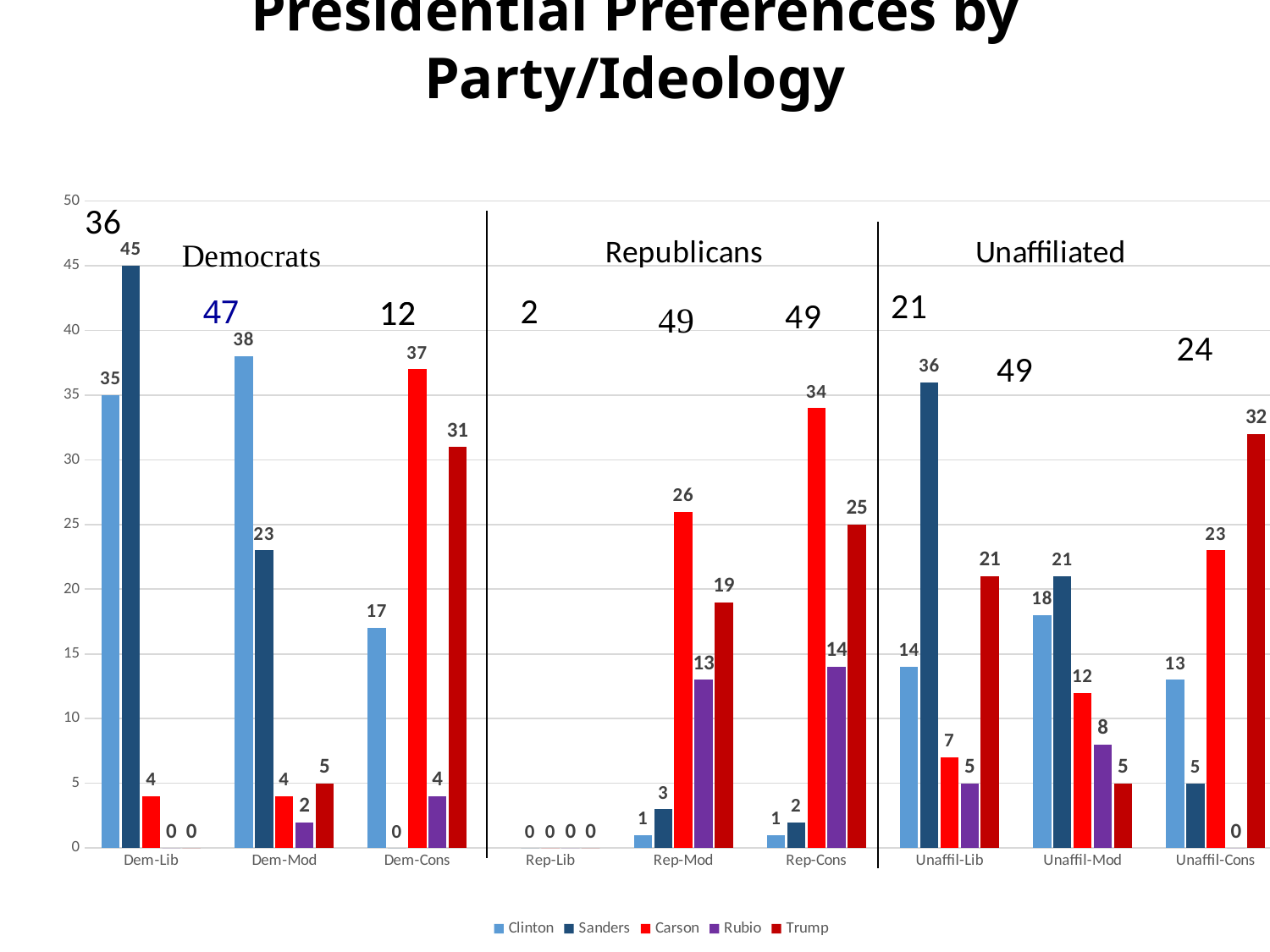
Which candidate has the lowest value in the Dem-Cons category? Sanders What is the value for Sanders in the Dem-Lib category? 45 Which candidate is shown in purple in the legend? Rubio How many categories are shown on the x axis? 9 Which is larger in the Dem-Mod category, Clinton or Sanders? Clinton What is the difference between Carson and Trump in the Rep-Mod category? 7 What kind of chart is shown on the slide? Bar chart How many series does the legend list? 5 What is the value for Trump in the Unaffil-Cons category? 32 What is the value for Carson in the Rep-Cons category? 34 Which candidate has the highest value in the Unaffil-Lib category? Sanders Is the value for Carson in the Dem-Cons category greater or less than 30? greater